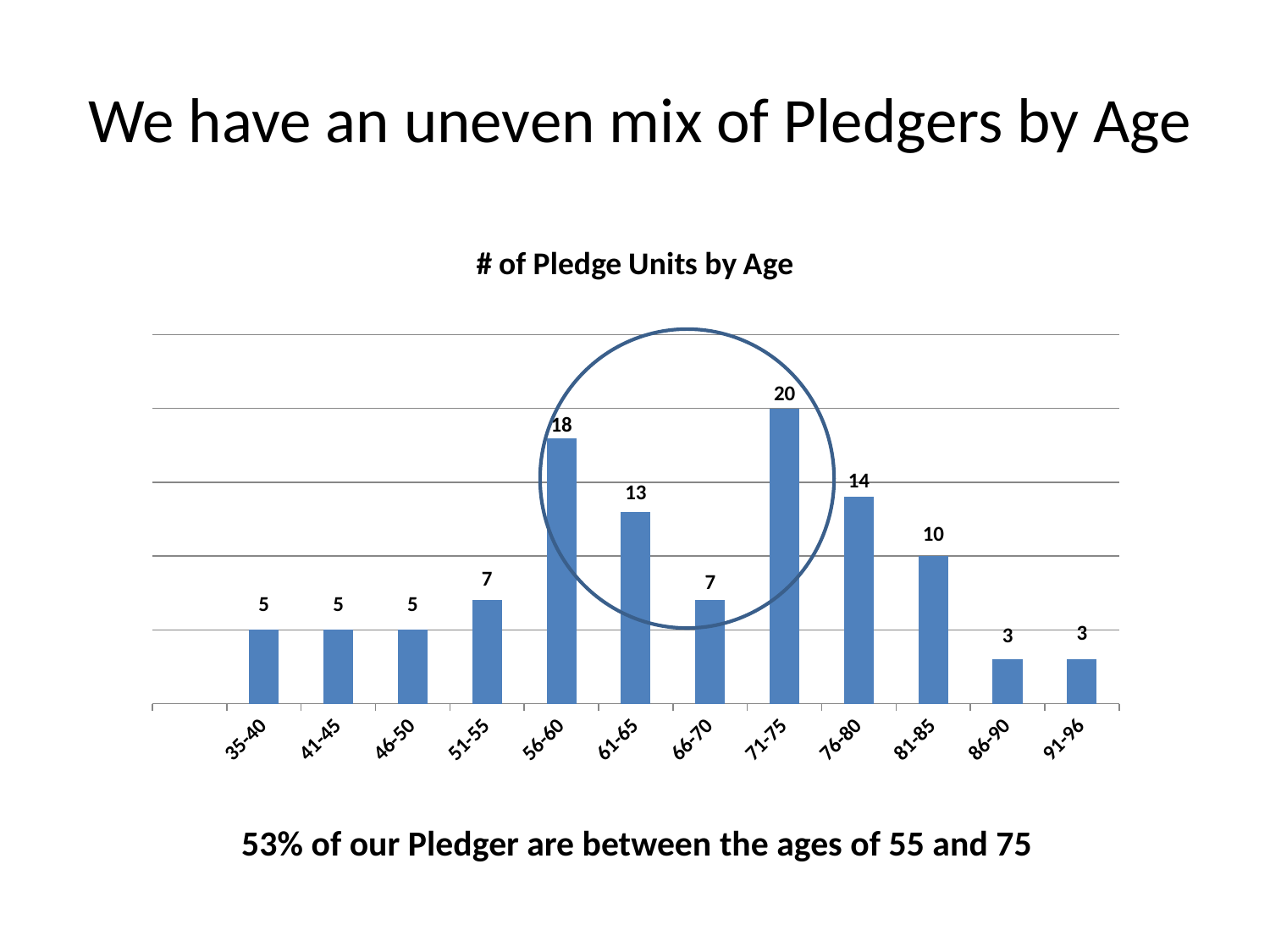
What is the number of pledge units for the 56-60 age group? 18 Do the values rise or fall from the 71-75 age group to the 91-96 age group? Fall What is the difference in pledge units between the 71-75 and 61-65 age groups? 7 What is the title of the chart? # of Pledge Units by Age How many age groups are shown on the x axis? 12 What is the number of pledge units for the 81-85 age group? 10 What is the number of pledge units for the 76-80 age group? 14 What is the difference in pledge units between the 56-60 and 66-70 age groups? 11 Which age group has the highest number of pledge units? 71-75 What kind of chart is shown on the slide? Bar chart Which age group has more pledge units, 61-65 or 76-80? 76-80 Which age group has more pledge units, 51-55 or 81-85? 81-85